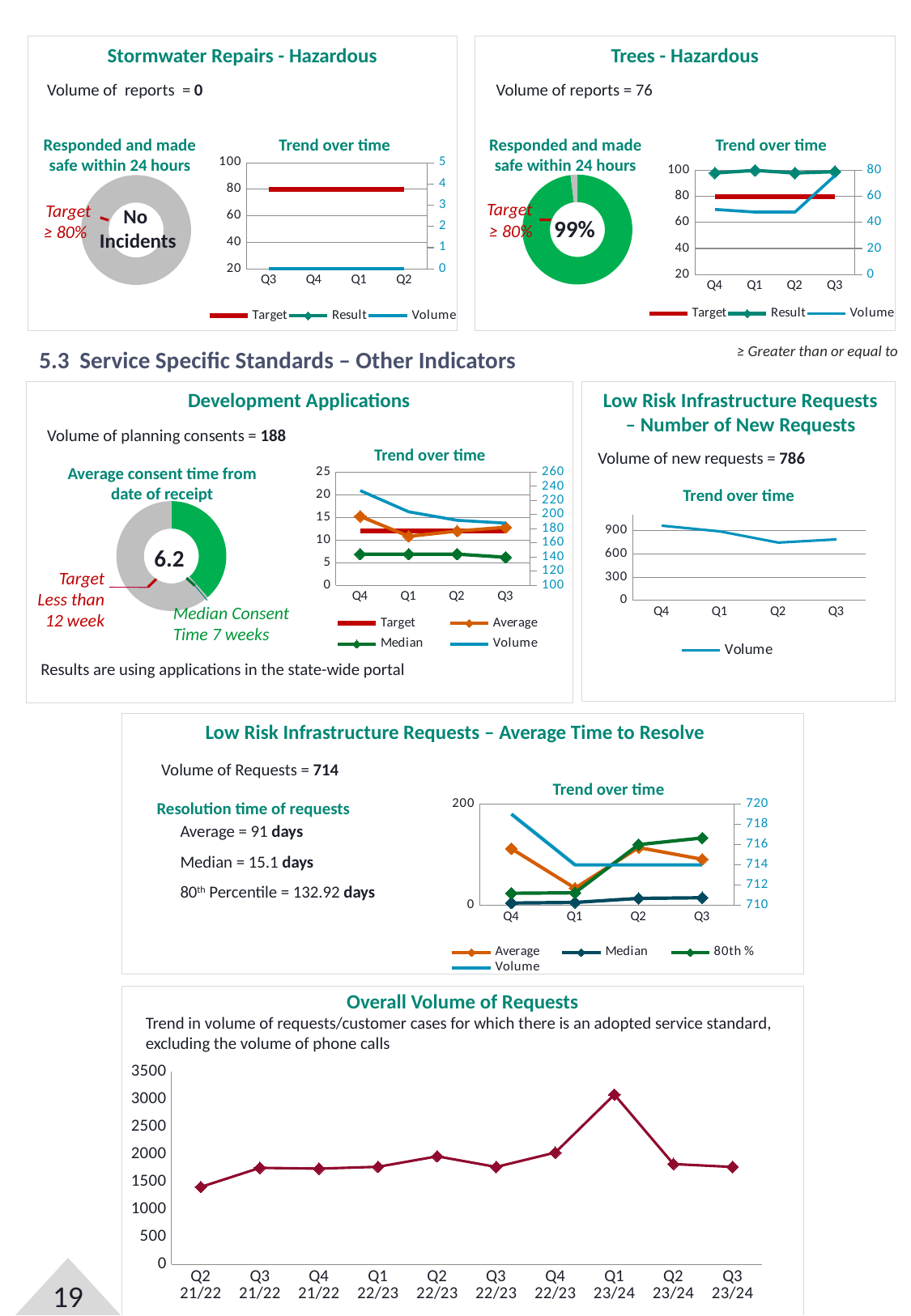
How many series does the legend list in the Trees - Hazardous trend over time chart? 3 In the Trees - Hazardous panel, what percentage is shown in the centre of the donut chart? 99% In the Overall Volume of Requests chart, which quarter has the lowest volume? Q2 21/22 In the Overall Volume of Requests chart, is the value for Q2 21/22 greater or less than 1500? less How many series does the legend list in the Development Applications trend over time chart? 4 In the Overall Volume of Requests chart, how many quarters are plotted? 10 What kind of chart is the Overall Volume of Requests chart? line chart In the Overall Volume of Requests chart, is the value for Q1 23/24 greater or less than 2500? greater In the Low Risk Infrastructure Requests – Number of New Requests trend chart, which quarter has the lowest volume? Q2 In the Stormwater Repairs - Hazardous trend over time chart, what value does the Target line sit at on the left axis? 80 In the Overall Volume of Requests chart, which quarter has the highest volume? Q1 23/24 In the Development Applications trend over time chart, does the Volume line rise or fall from Q4 to Q3? fall